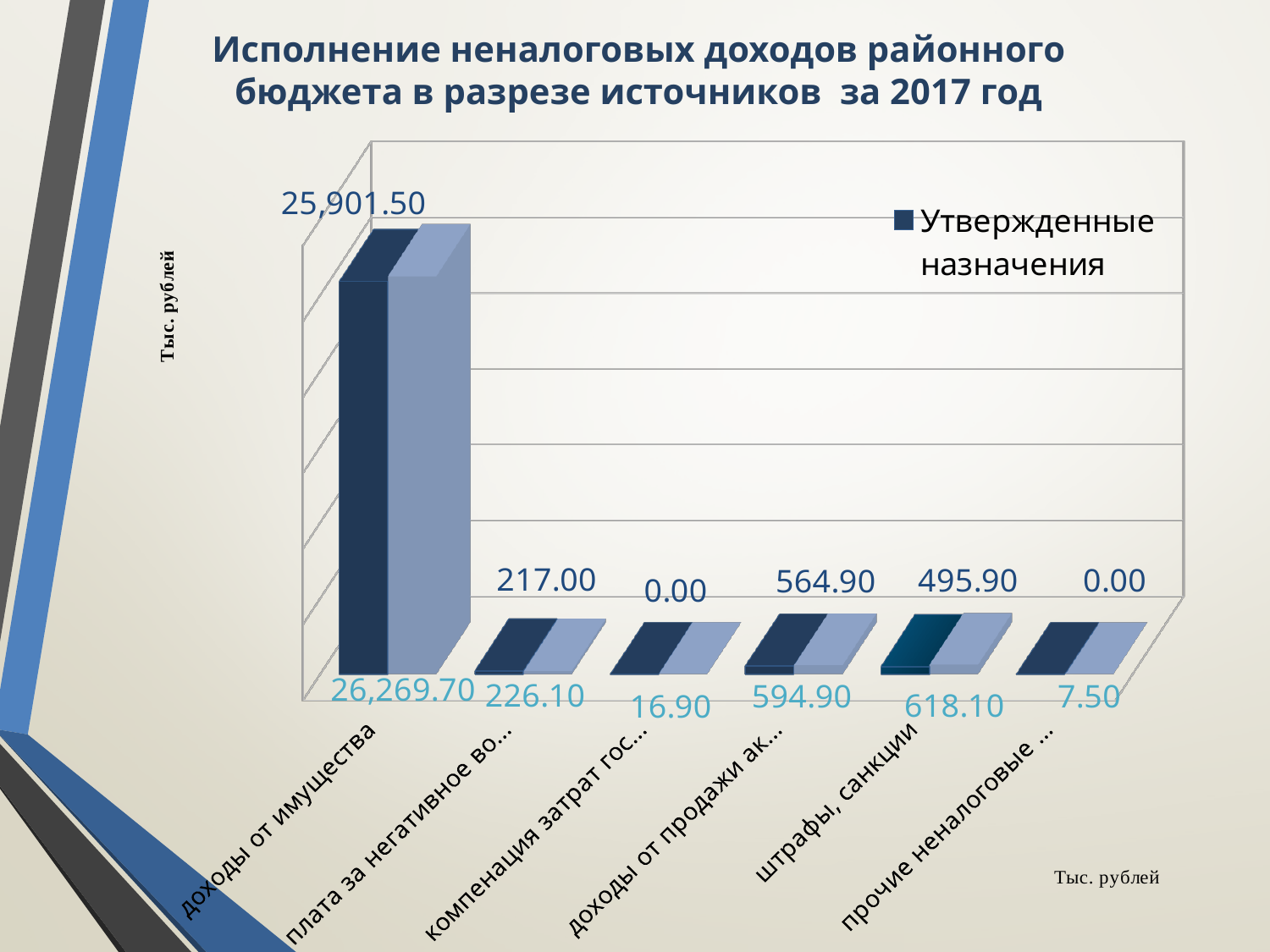
What unit is shown on the vertical axis label of the chart? Тыс. рублей What is the difference between the Утвержденные назначения values for the category beginning 'доходы от продажи' (564.90) and штрафы, санкции (495.90)? 69.00 How many categories are shown on the x axis of the chart? 6 What is the value of Утвержденные назначения for штрафы, санкции? 495.90 Which has a larger Утвержденные назначения value: штрафы, санкции or the category beginning 'плата за негативное'? штрафы, санкции What is the title of the chart on the slide? Исполнение неналоговых доходов районного бюджета в разрезе источников за 2017 год How many series does the chart legend list? 1 What is the light-blue data label shown below the bar for доходы от имущества? 26,269.70 How many categories have an Утвержденные назначения value of 0.00? 2 What is the value of Утвержденные назначения for доходы от имущества? 25,901.50 Which category has the highest value of Утвержденные назначения? доходы от имущества What kind of chart is shown on the slide? bar chart